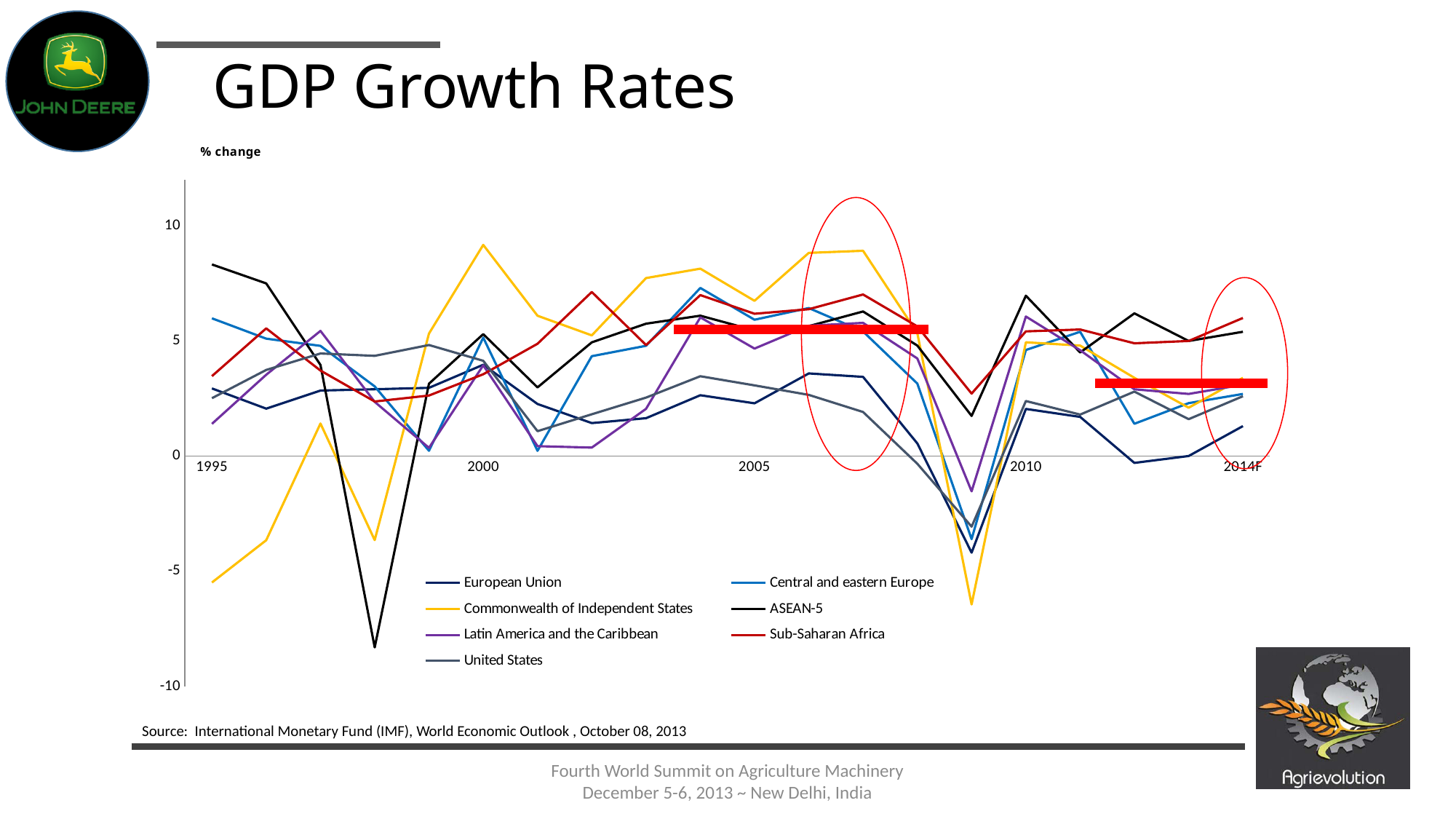
What unit label is shown above the y axis? % change What kind of chart is shown on the slide? line chart How many series does the legend list? 7 Is the value for ASEAN-5 in 1998 greater or less than -5? less What is the title of the chart? GDP Growth Rates Is the value for Commonwealth of Independent States in 2000 greater or less than 5? greater In 2009, which is lower: Commonwealth of Independent States or European Union? Commonwealth of Independent States Is the value for Sub-Saharan Africa in 2009 greater or less than 0? greater Which series reaches the lowest point on the chart? ASEAN-5 Which series reaches the highest point on the chart? Commonwealth of Independent States